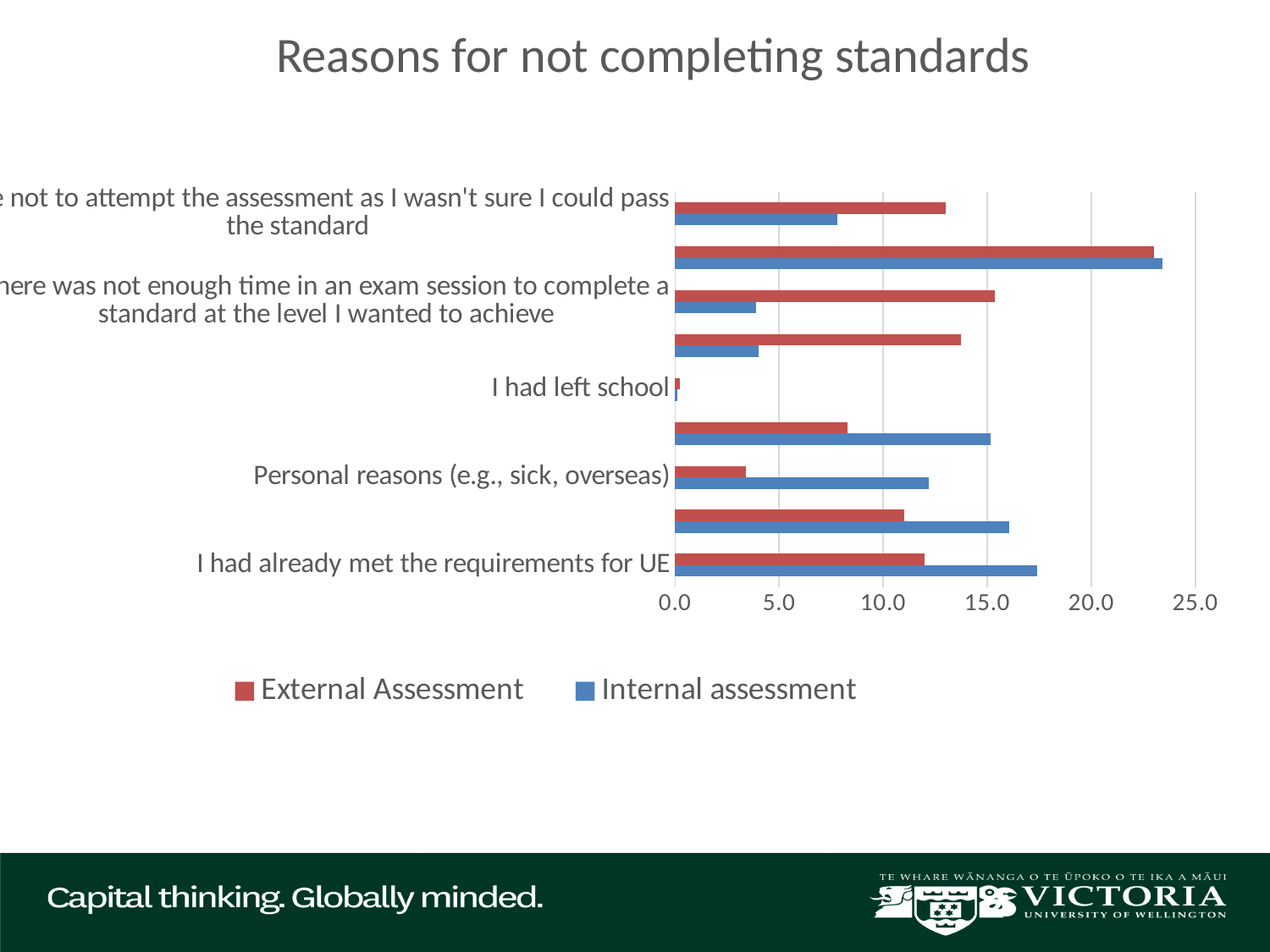
Is the Internal assessment value for 'Personal reasons (e.g., sick, overseas)' greater or less than 10.0? greater Is the External Assessment value for 'I had left school' greater or less than 5.0? less Is the External Assessment value for 'I had already met the requirements for UE' greater or less than 15.0? less How many series does the legend list? 2 For 'I had already met the requirements for UE', which series has the larger value, External Assessment or Internal assessment? Internal assessment For 'Personal reasons (e.g., sick, overseas)', which series has the larger value, External Assessment or Internal assessment? Internal assessment What are the two series named in the legend? External Assessment and Internal assessment What is the title of the chart? Reasons for not completing standards For the category ending 'I wasn't sure I could pass the standard', which series has the larger value, External Assessment or Internal assessment? External Assessment What kind of chart is shown on the slide? Bar chart